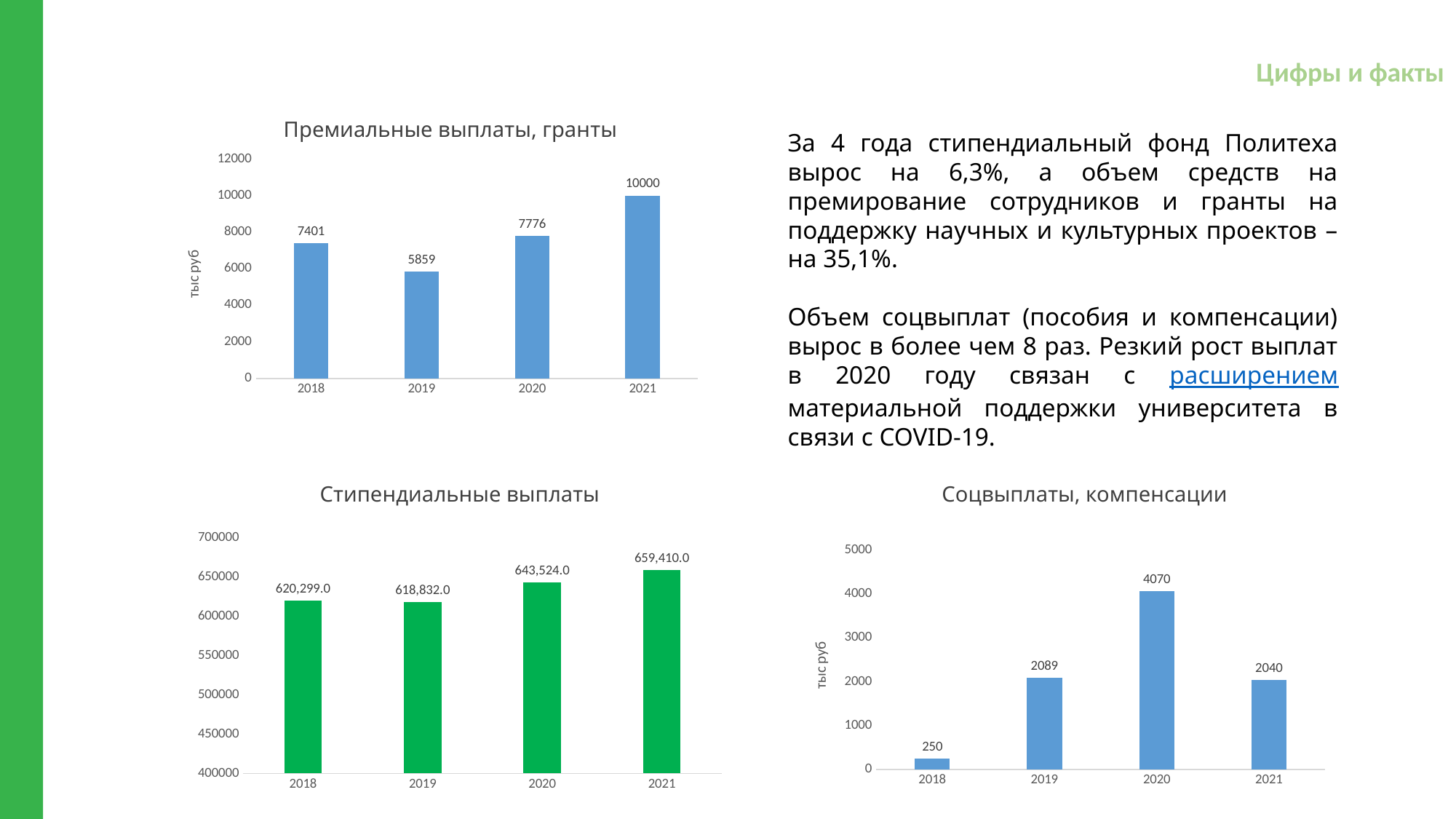
In the chart titled "Стипендиальные выплаты", what is the value for 2020? 643,524.0 In the chart titled "Премиальные выплаты, гранты", what is the difference between the values for 2021 and 2018? 2599 In the chart titled "Премиальные выплаты, гранты", what is the value for 2019? 5859 What kind of chart is the chart titled "Стипендиальные выплаты"? Bar chart What is the y-axis label of the chart titled "Премиальные выплаты, гранты"? тыс руб In the chart titled "Соцвыплаты, компенсации", which year has the highest value? 2020 In the chart titled "Соцвыплаты, компенсации", what is the value for 2018? 250 In the chart titled "Премиальные выплаты, гранты", which year has the highest value? 2021 In the chart titled "Стипендиальные выплаты", which is larger, the value for 2018 or the value for 2019? 2018 How many years are shown in the chart titled "Соцвыплаты, компенсации"? 4 In the chart titled "Соцвыплаты, компенсации", what is the difference between the values for 2020 and 2021? 2030 In the chart titled "Стипендиальные выплаты", which year has the lowest value? 2019